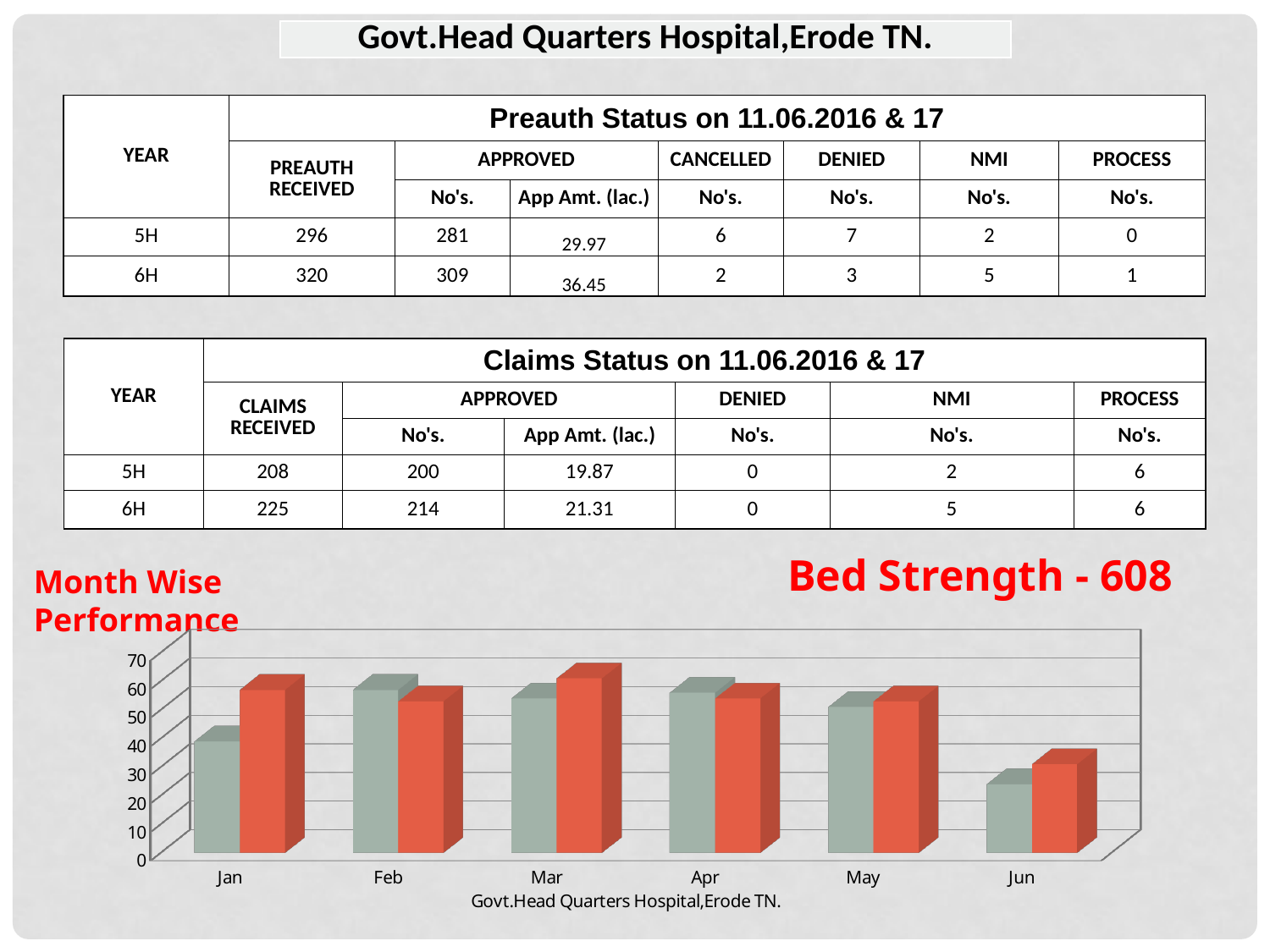
In Jan, which bar is taller, the grey bar or the red bar? the red bar How many months are shown on the x axis of the bar chart? 6 What is the title printed below the bar chart? Govt.Head Quarters Hospital,Erode TN. Is the value of the grey bar for Jun greater or less than 30? less Which month has the lowest grey bar? Jun Do the red bars rise or fall from May to Jun? fall Which month has the highest red bar? Mar Is the value of the red bar for Jun greater or less than 40? less Is the value of the grey bar for Jan greater or less than 50? less What kind of chart is shown at the bottom of the slide? bar chart What is the highest value shown on the vertical axis of the bar chart? 70